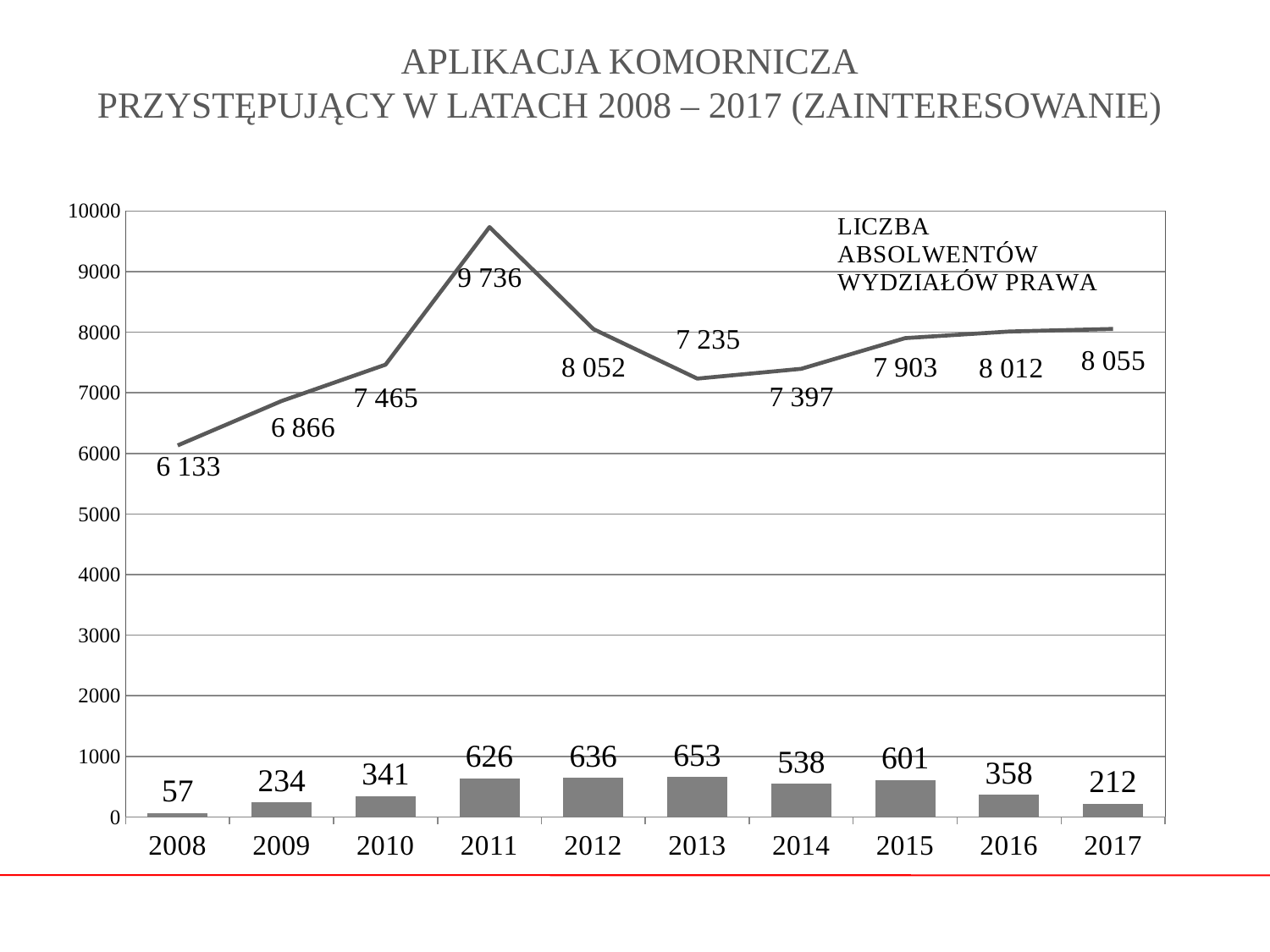
What is the value of the bar for 2013? 653 Do the bar values rise or fall from 2008 to 2011? rise Which is larger, the bar value for 2015 or the bar value for 2014? 2015 What is the difference between the bar values for 2013 and 2008? 596 What is the difference between the line values for 2011 and 2010? 2 271 Is the line value for 2011 greater or less than 9000? greater What kind of chart is shown on the slide? Combined bar and line chart What is the value of the line labelled LICZBA ABSOLWENTÓW WYDZIAŁÓW PRAWA for 2011? 9 736 What is the value of the bar for 2008? 57 Which year has the highest bar value? 2013 How many years are shown on the x axis? 10 Which year has the lowest value on the LICZBA ABSOLWENTÓW WYDZIAŁÓW PRAWA line? 2008